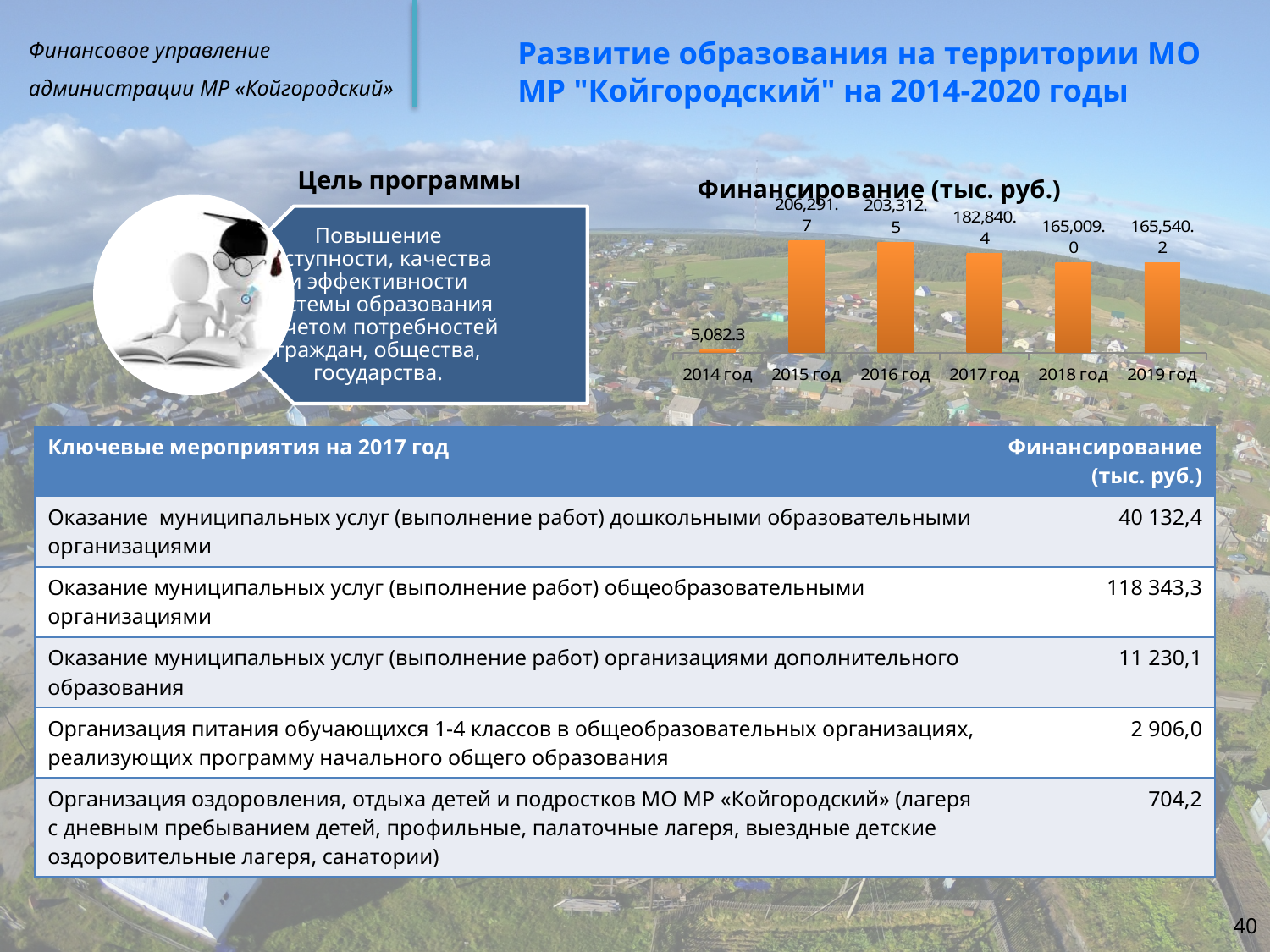
Do the values in the Финансирование (тыс. руб.) chart rise or fall from 2015 год to 2018 год? Fall Which year has the lowest value in the Финансирование (тыс. руб.) chart? 2014 год What is the value for 2019 год in the Финансирование (тыс. руб.) chart? 165,540.2 Which year has the highest value in the Финансирование (тыс. руб.) chart? 2015 год In the Финансирование (тыс. руб.) chart, which is larger: the value for 2018 год or 2019 год? 2019 год What is the value for 2017 год in the Финансирование (тыс. руб.) chart? 182,840.4 What is the difference between the values for 2015 год and 2016 год in the Финансирование (тыс. руб.) chart? 2,979.2 What kind of chart is the Финансирование (тыс. руб.) chart? Bar chart How many years are shown in the Финансирование (тыс. руб.) chart? 6 What is the difference between the values for 2017 год and 2018 год in the Финансирование (тыс. руб.) chart? 17,831.4 What is the value for 2015 год in the Финансирование (тыс. руб.) chart? 206,291.7 What is the value for 2014 год in the Финансирование (тыс. руб.) chart? 5,082.3